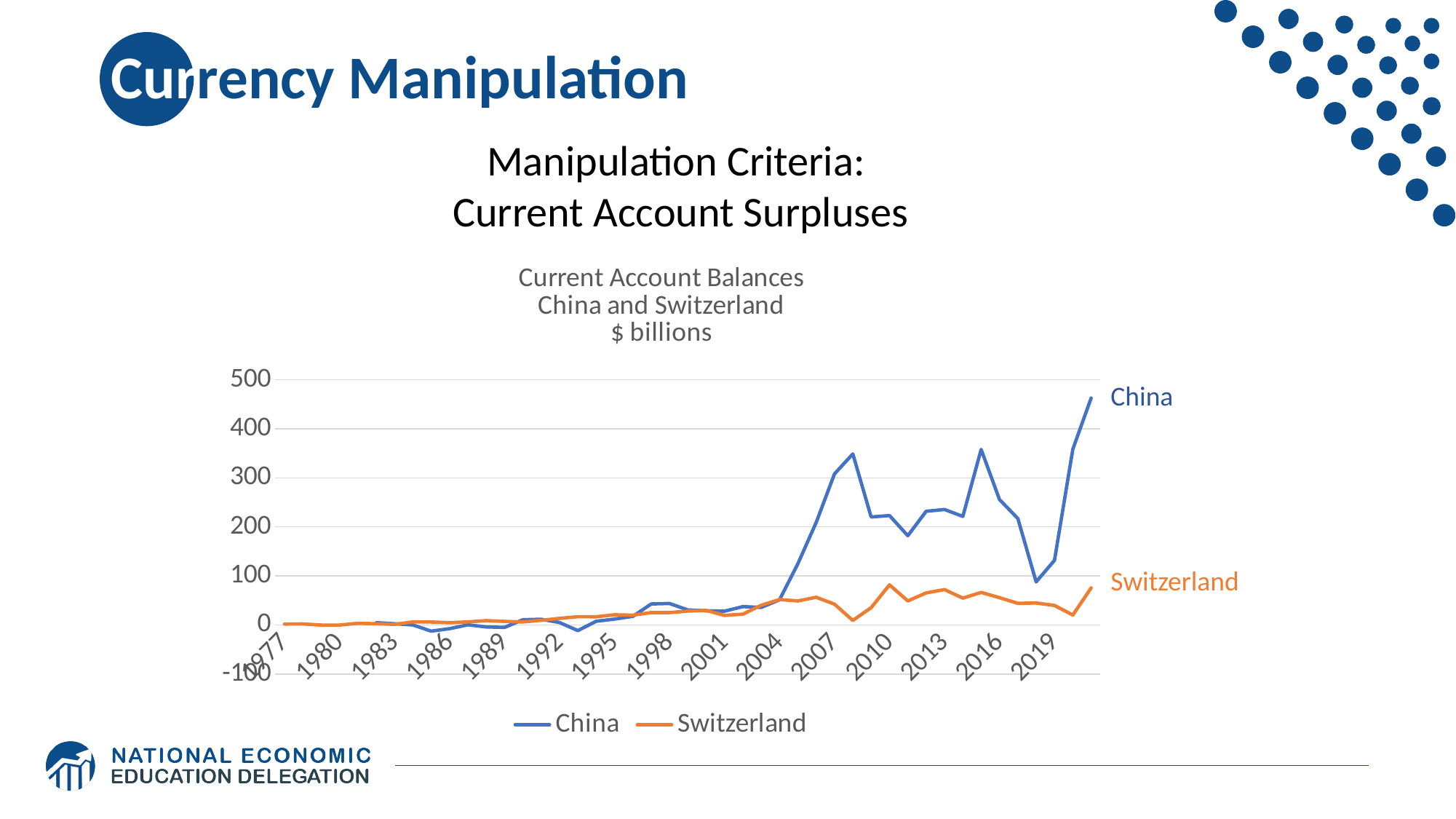
How many year labels are shown on the x axis? 15 Which series reaches the highest value on the chart? China Is the highest point of the China line greater or less than 400? greater What kind of chart is shown on the slide? line chart Is the highest point of the Switzerland line greater or less than 100? less At the right end of the chart, which series has the larger value, China or Switzerland? China Does the China line overall rise or fall from 1977 to the end of the series? rise Is the value for Switzerland in 2010 greater or less than 200? less Which two countries are plotted in the chart? China and Switzerland How many series does the legend list? 2 What unit is given in the chart title? $ billions